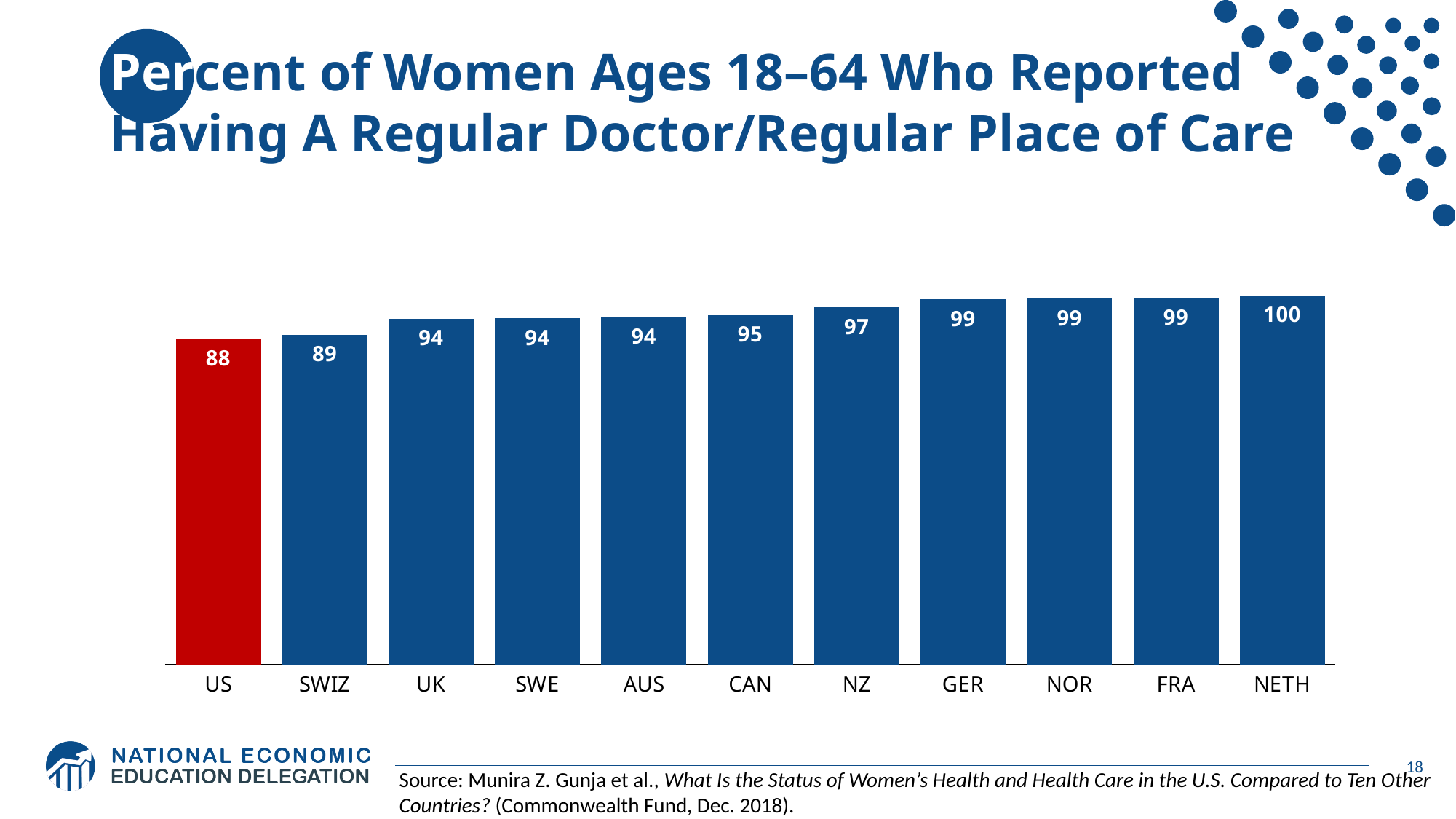
What is the value for the US? 88 Which has a larger value, UK or NZ? NZ Which country has the lowest value? US What kind of chart is this? bar chart What is the value for NZ? 97 What is the value for CAN? 95 What is the difference between the values for SWIZ and the US? 1 Which country has the highest value? NETH What is the difference between the values for NETH and the US? 12 Do the values rise or fall from left to right across the chart? rise Which bar is coloured red? US How many countries are shown in the chart? 11